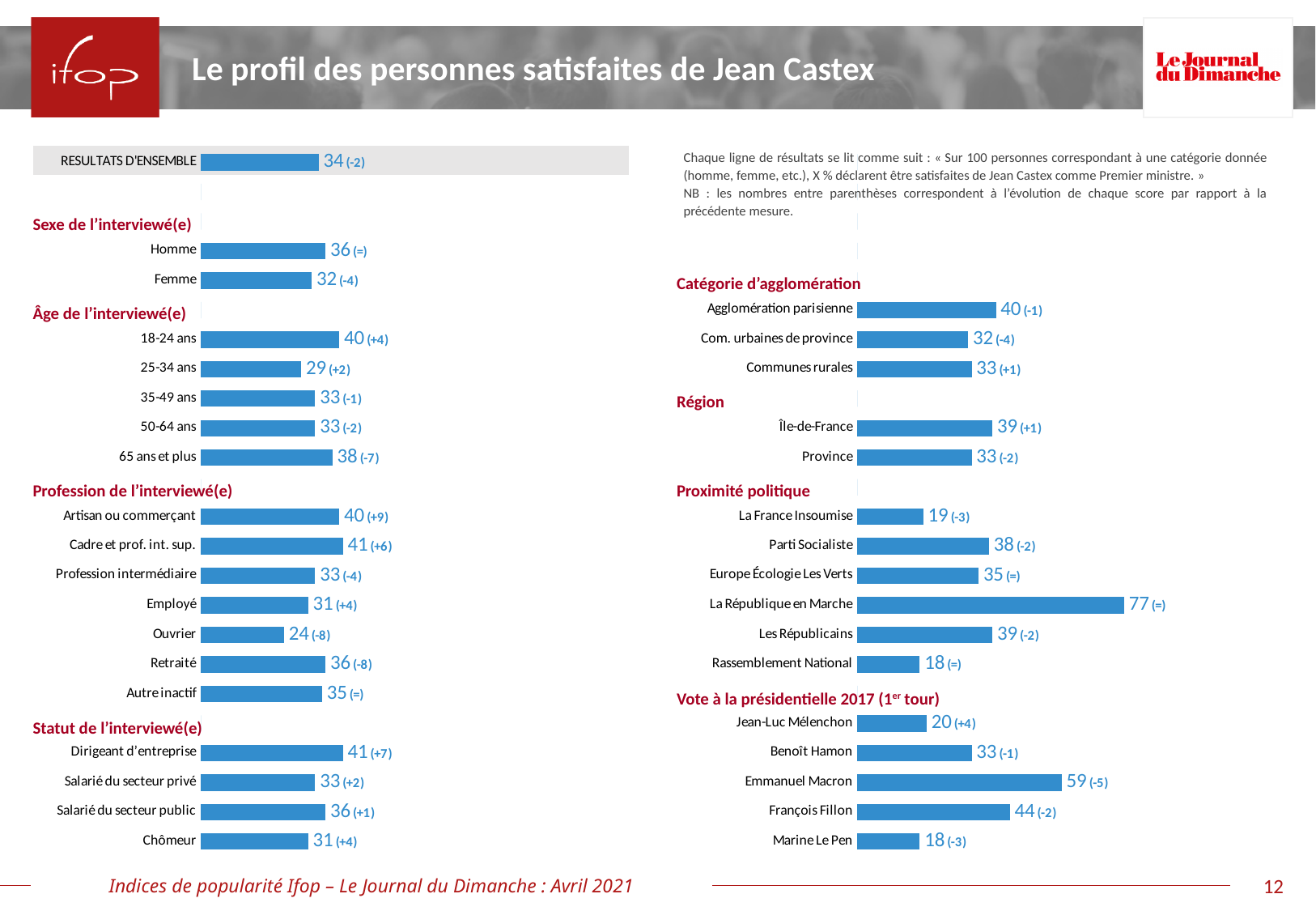
On the left chart, what is the value for RESULTATS D'ENSEMBLE? 34 On the right chart, what change in parentheses is shown next to the value for Emmanuel Macron? (-5) On the left chart, what is the difference between the values for Homme and Femme? 4 On the right chart, what is the value for La République en Marche under Proximité politique? 77 On the right chart, which category under Vote à la présidentielle 2017 (1er tour) has the highest value? Emmanuel Macron On the left chart, which is larger, the value for 18-24 ans or the value for 25-34 ans? 18-24 ans On the left chart, how many categories are listed under Profession de l'interviewé(e)? 7 On the right chart, which category under Proximité politique has the lowest value? Rassemblement National On the right chart, what is the difference between the values for Emmanuel Macron and François Fillon? 15 What kind of chart is used on the slide? Bar chart On the right chart, how many categories are listed under Proximité politique? 6 On the left chart, what is the value for Ouvrier under Profession de l'interviewé(e)? 24